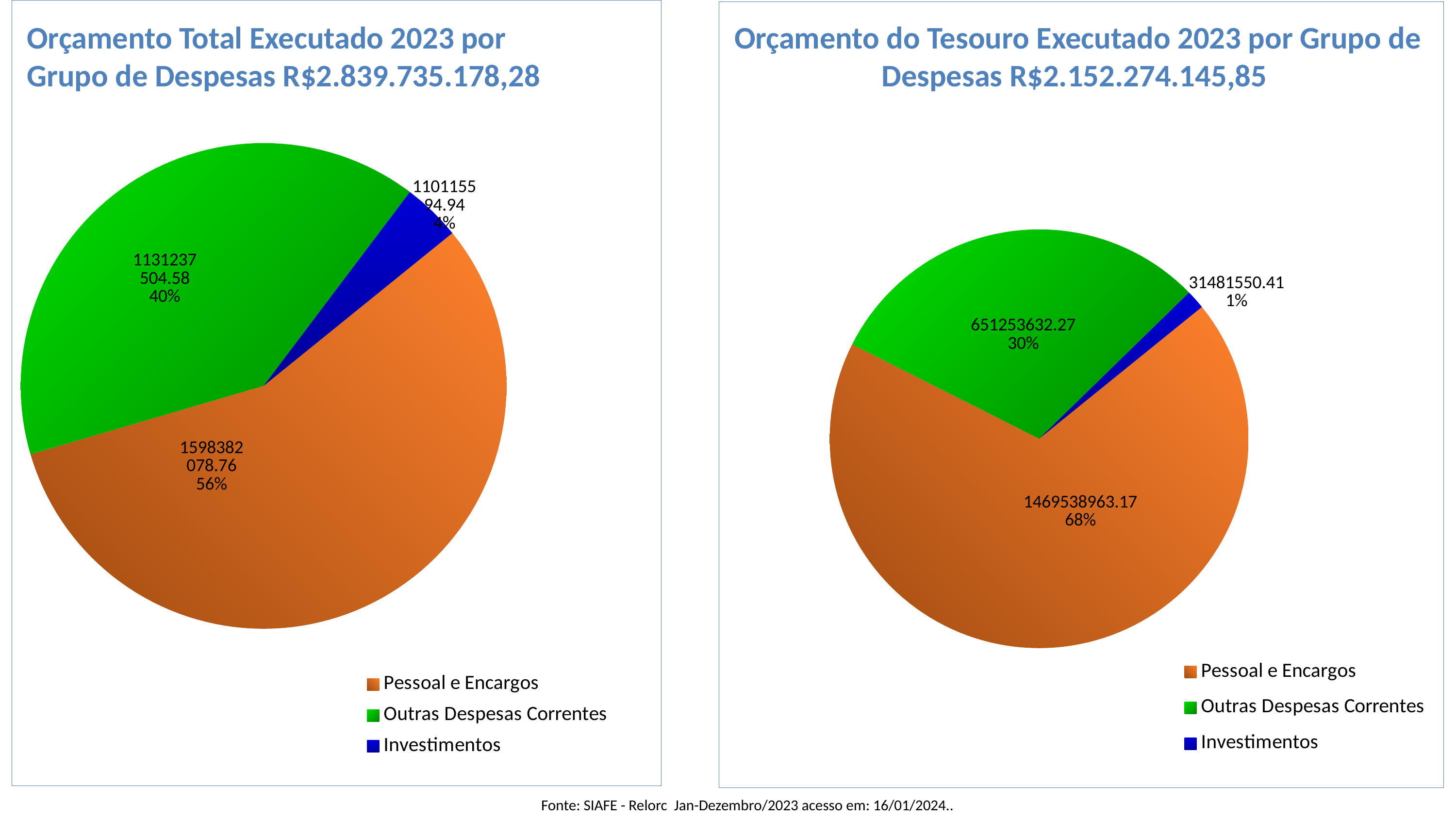
What kind of chart is the chart on the left of the slide? Pie chart In the chart titled "Orçamento do Tesouro Executado 2023 por Grupo de Despesas", what is the value for Investimentos? 31481550.41 In the chart titled "Orçamento do Tesouro Executado 2023 por Grupo de Despesas", what share of the pie is Pessoal e Encargos? 68% In the chart titled "Orçamento do Tesouro Executado 2023 por Grupo de Despesas", what is the value for Pessoal e Encargos? 1469538963.17 How many categories does the legend of the chart on the right of the slide list? 3 In the chart titled "Orçamento Total Executado 2023 por Grupo de Despesas", which category has the largest slice? Pessoal e Encargos In the chart titled "Orçamento Total Executado 2023 por Grupo de Despesas", what share of the pie is Investimentos? 4% In the chart titled "Orçamento do Tesouro Executado 2023 por Grupo de Despesas", which is larger, Outras Despesas Correntes or Investimentos? Outras Despesas Correntes In the chart titled "Orçamento do Tesouro Executado 2023 por Grupo de Despesas", what is the value for Outras Despesas Correntes? 651253632.27 In the chart titled "Orçamento Total Executado 2023 por Grupo de Despesas", what share of the pie is Outras Despesas Correntes? 40% In the chart titled "Orçamento do Tesouro Executado 2023 por Grupo de Despesas", which category has the smallest slice? Investimentos